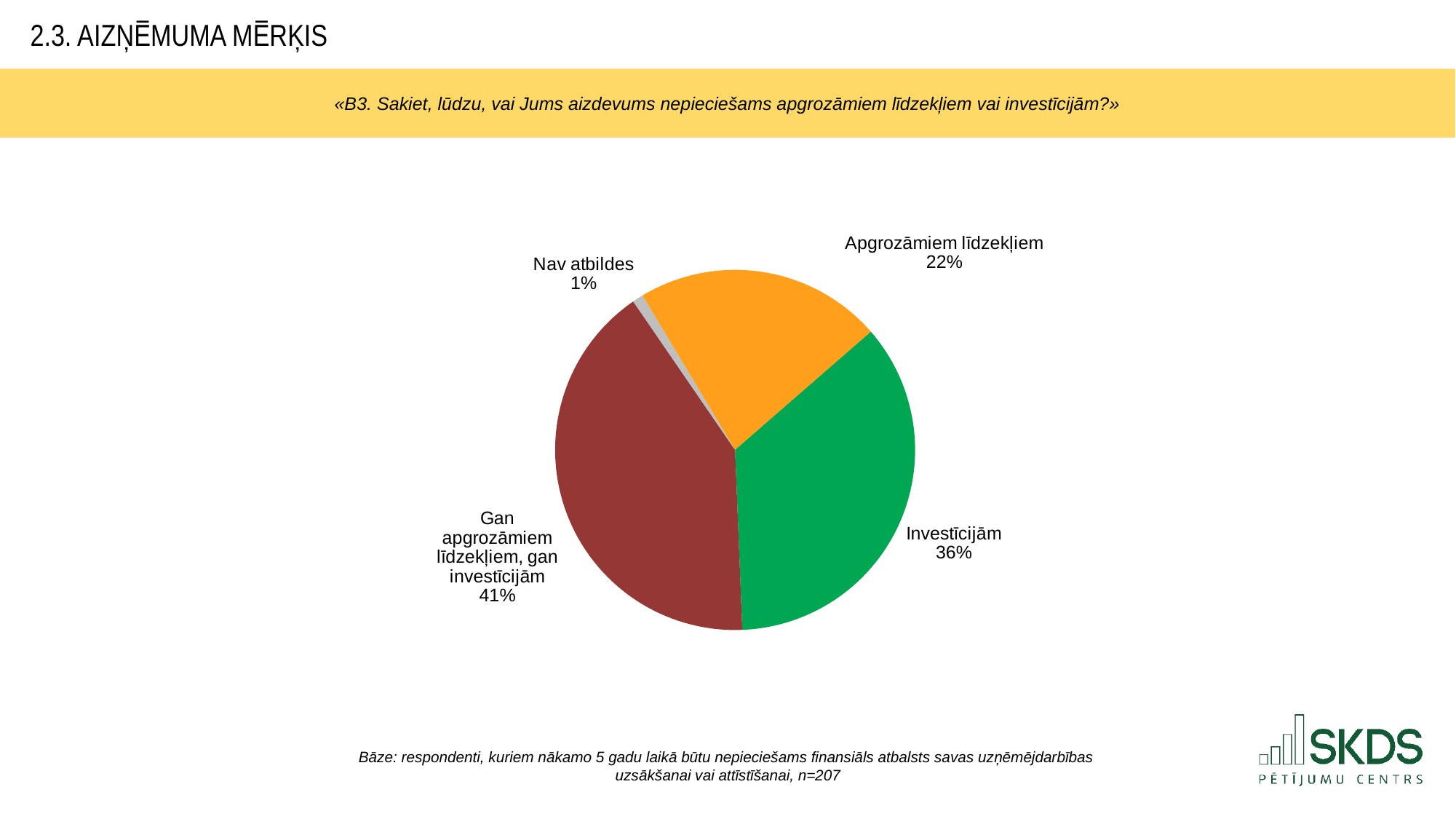
Which category has the largest slice of the pie? Gan apgrozāmiem līdzekļiem, gan investīcijām How many categories are shown in the pie chart? 4 What is the difference in percentage points between "Investīcijām" and "Apgrozāmiem līdzekļiem"? 14 percentage points What colour is the slice for "Investīcijām"? Green What share of respondents gave no answer ("Nav atbildes")? 1% Which category has the smallest slice of the pie? Nav atbildes What share of respondents answered "Gan apgrozāmiem līdzekļiem, gan investīcijām"? 41% What kind of chart is shown on the slide? Pie chart What share of respondents answered "Investīcijām"? 36% What is the sample size (n) stated in the base note below the chart? n=207 What share of respondents answered "Apgrozāmiem līdzekļiem"? 22% Which is larger: the share for "Investīcijām" or for "Apgrozāmiem līdzekļiem"? Investīcijām